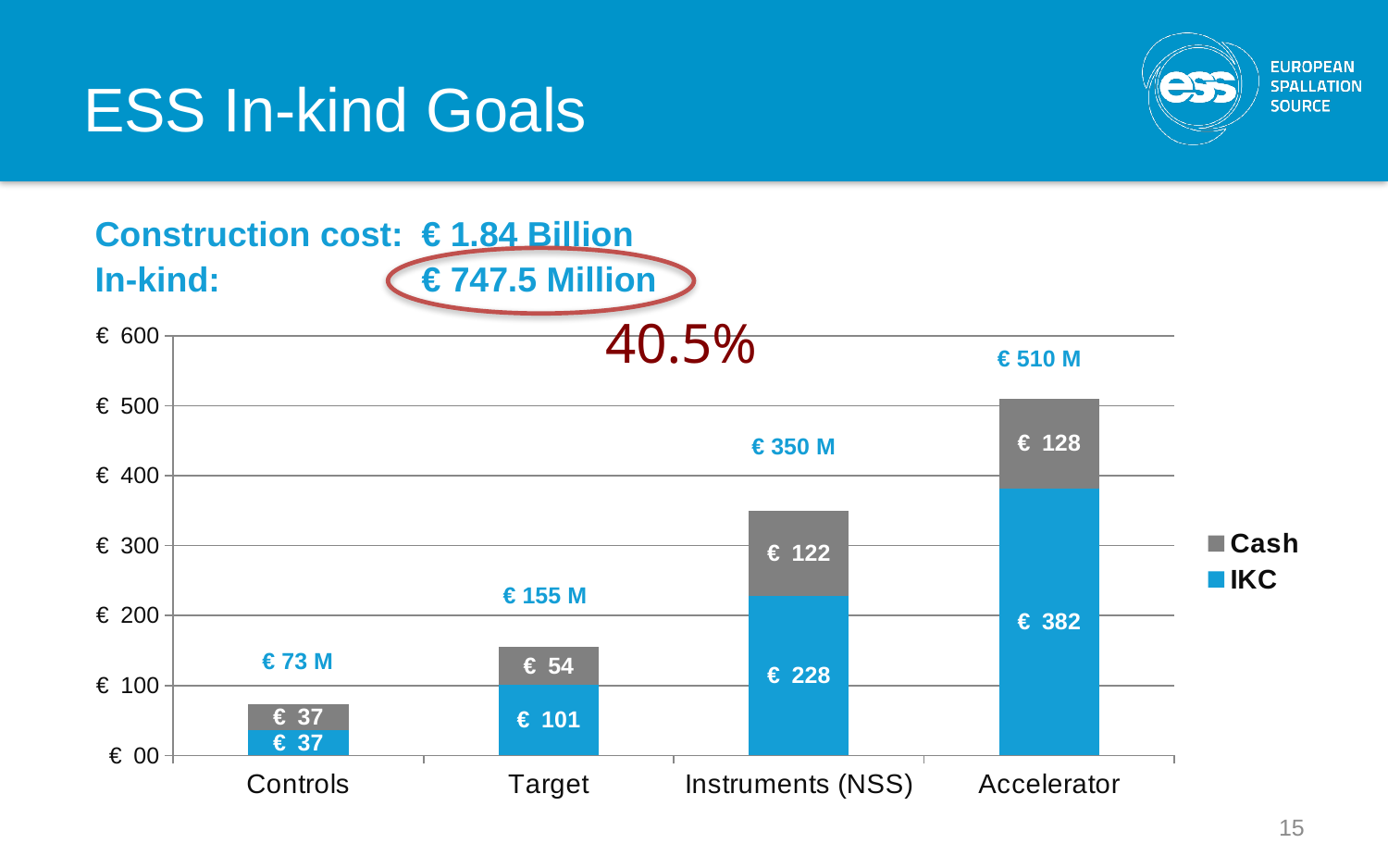
What is the difference between the Cash values for Accelerator and Target? € 74 Which category has the highest total bar? Accelerator What is the Cash value for Instruments (NSS)? € 122 How many categories are shown on the x axis of the chart? 4 What type of chart is shown on the slide? Stacked bar chart What total is labelled above the Accelerator bar? € 510 M How many series does the chart legend list? 2 What is the IKC value for Target? € 101 Which is larger, the IKC value for Instruments (NSS) or the Cash value for Accelerator? IKC value for Instruments (NSS) What is the IKC value for Accelerator? € 382 Which series is shown in grey in the chart legend? Cash Which category has the lowest total bar? Controls